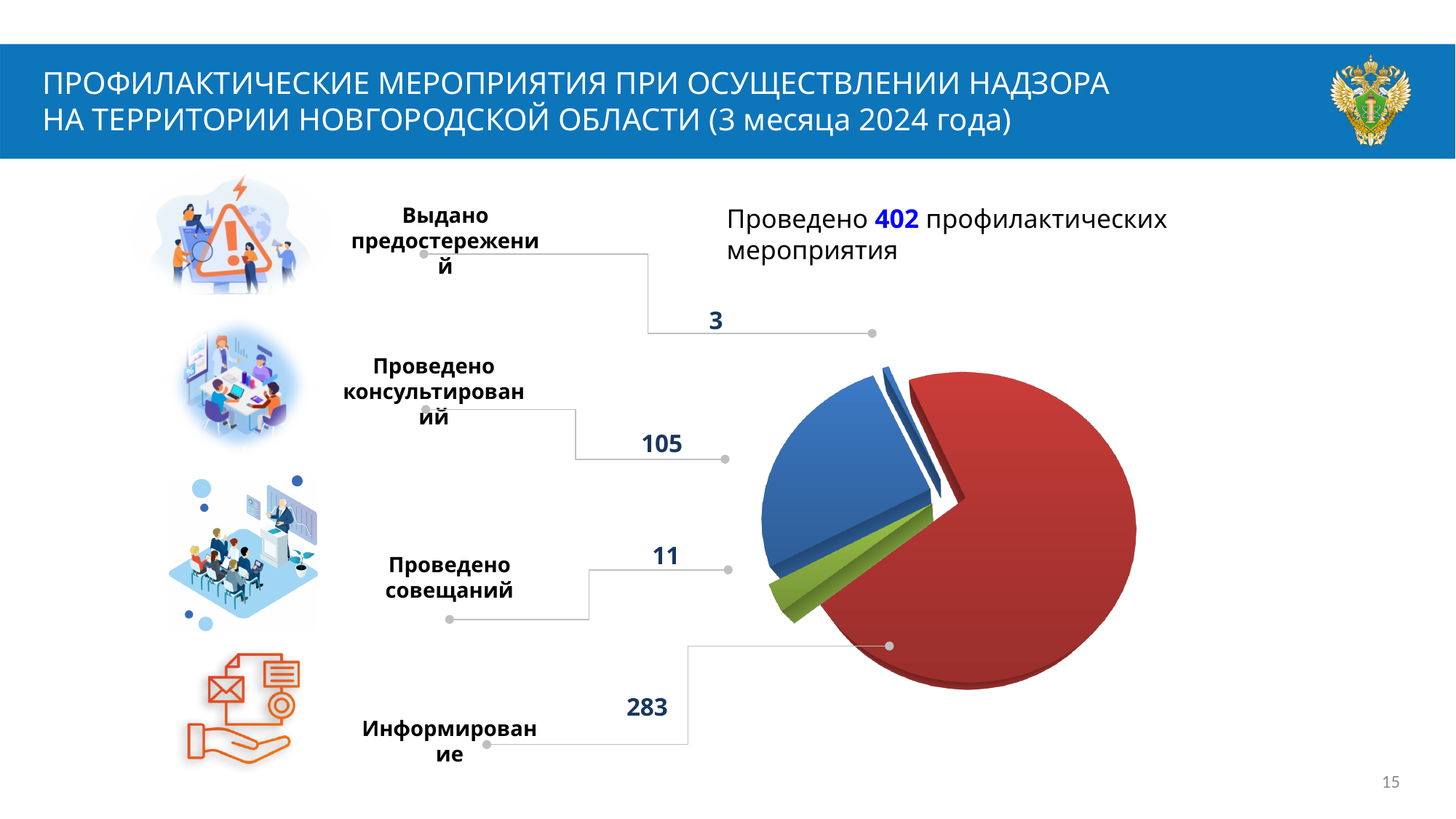
Which is larger: «Проведено консультирований» or «Проведено совещаний»? Проведено консультирований What is the total number of preventive measures (профилактических мероприятий) shown on the slide? 402 Which category has the largest value in the pie chart? Информирование What is the difference between «Информирование» and «Проведено консультирований»? 178 What is the value for «Информирование»? 283 How many slices does the pie chart have? 4 What is the value for «Проведено консультирований»? 105 What type of chart is shown on the slide? Pie chart Which category has the smallest value in the pie chart? Выдано предостережений What is the value for «Проведено совещаний»? 11 What is the value for «Выдано предостережений»? 3 What colour is the largest slice of the pie chart? Red